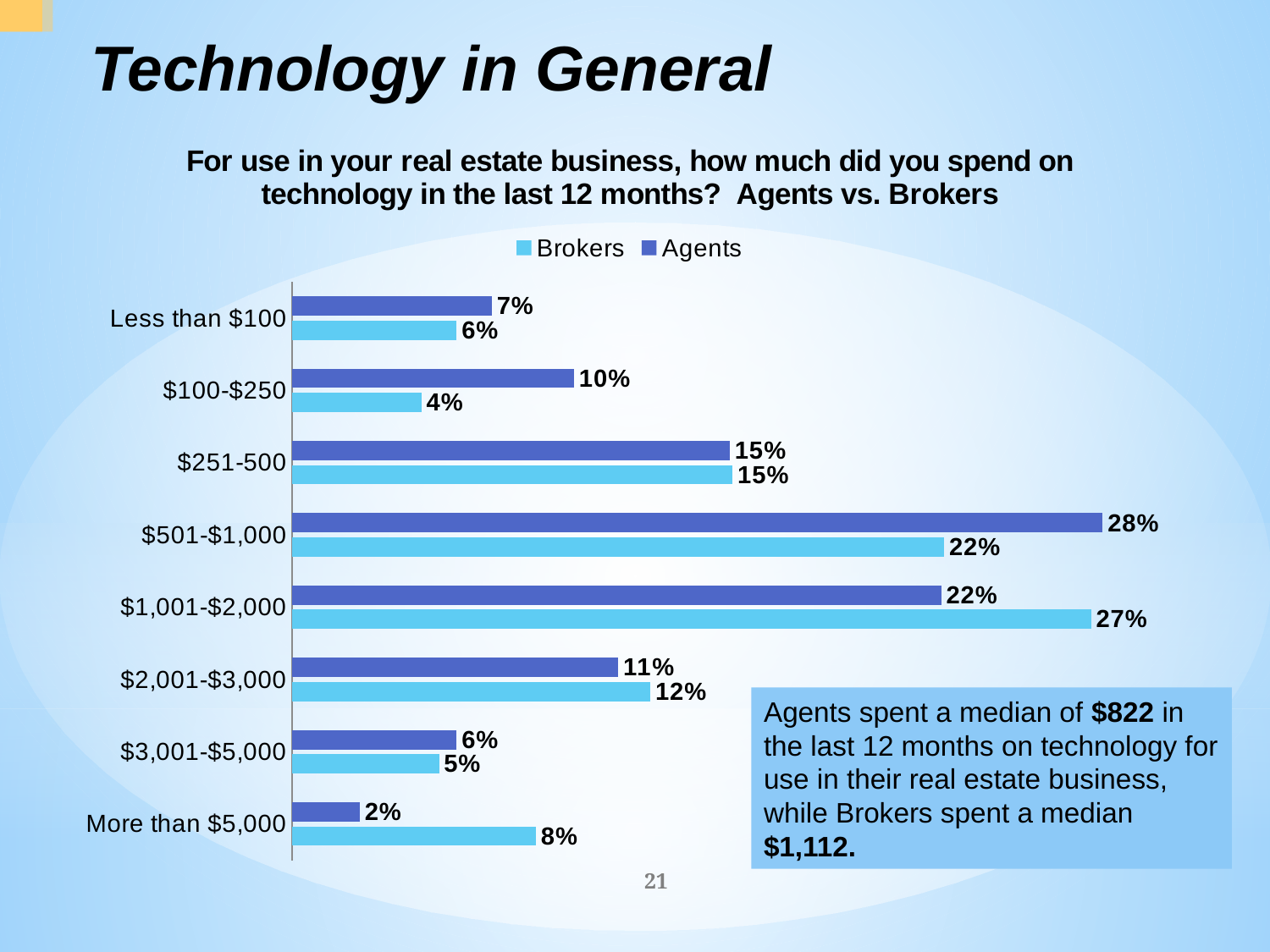
Which series is shown in the darker blue colour? Agents What type of chart is shown on the slide? Bar chart What is the difference between the Agents and Brokers percentages for the $100-$250 category? 6% What percentage of Brokers spent $1,001-$2,000 on technology in the last 12 months? 27% How many series does the legend list? 2 In the $501-$1,000 category, which group has the larger percentage, Agents or Brokers? Agents Which spending category has the highest percentage for Brokers? $1,001-$2,000 How many spending categories are shown on the chart? 8 Which spending category has the highest percentage for Agents? $501-$1,000 What percentage of Brokers spent more than $5,000 on technology? 8% Which spending category has the lowest percentage for Agents? More than $5,000 What percentage of Agents spent $501-$1,000 on technology in the last 12 months? 28%